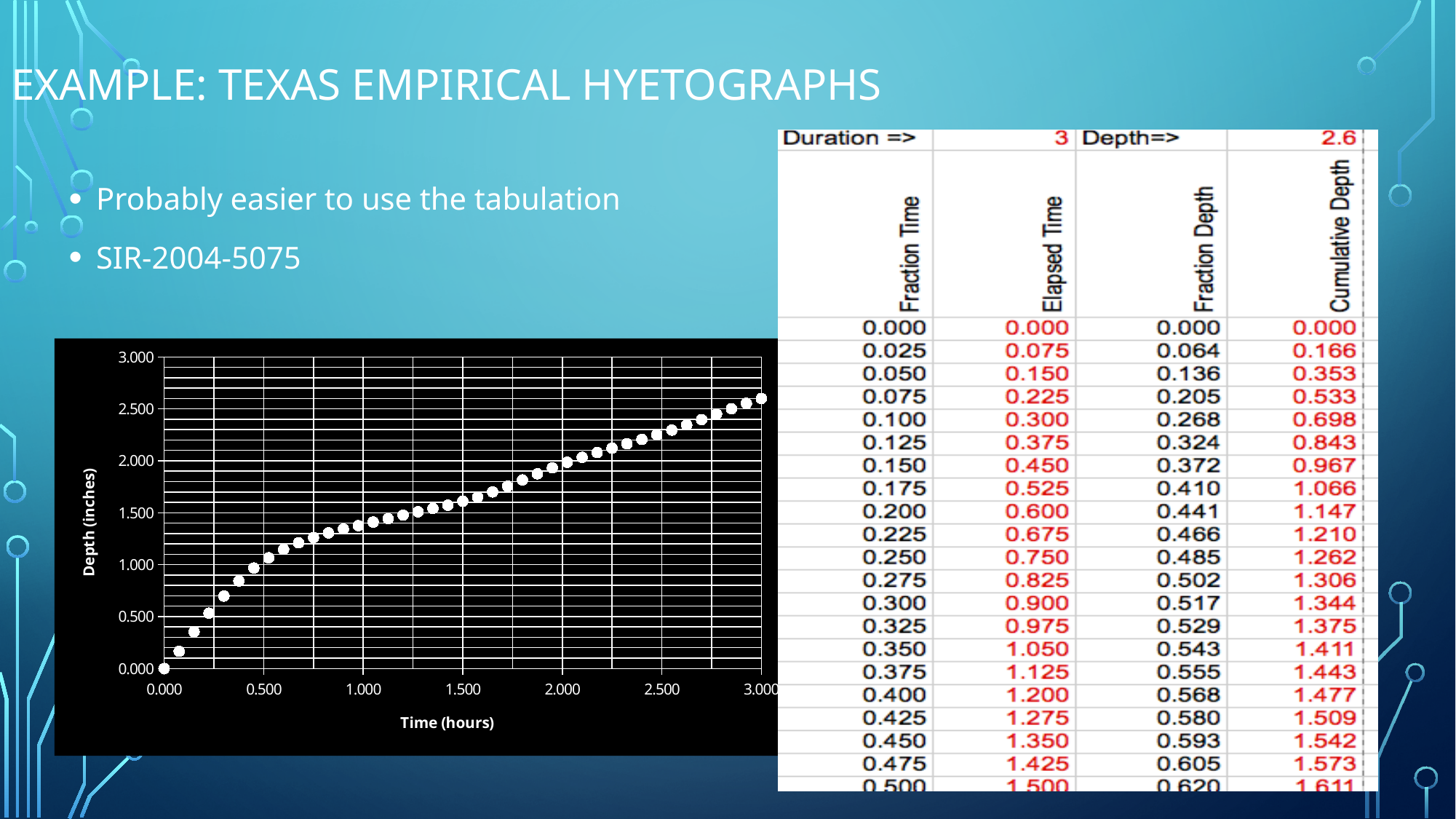
What is the label of the y axis of the chart? Depth (inches) Which has the larger plotted depth: the point at 2.500 hours or the point at 1.000 hours? 2.500 hours Is the depth value at 1.000 hours greater or less than 1.000? greater What kind of chart is shown on the slide? Scatter chart Is the depth value at 1.000 hours greater or less than 1.500? less At which time on the x axis is the plotted depth highest? 3.000 hours Is the depth value at 0.500 hours greater or less than 0.500? greater Do the plotted depth values rise or fall as time increases along the x axis? Rise What is the depth value plotted at time 0.000 hours? 0.000 What is the label of the x axis of the chart? Time (hours)